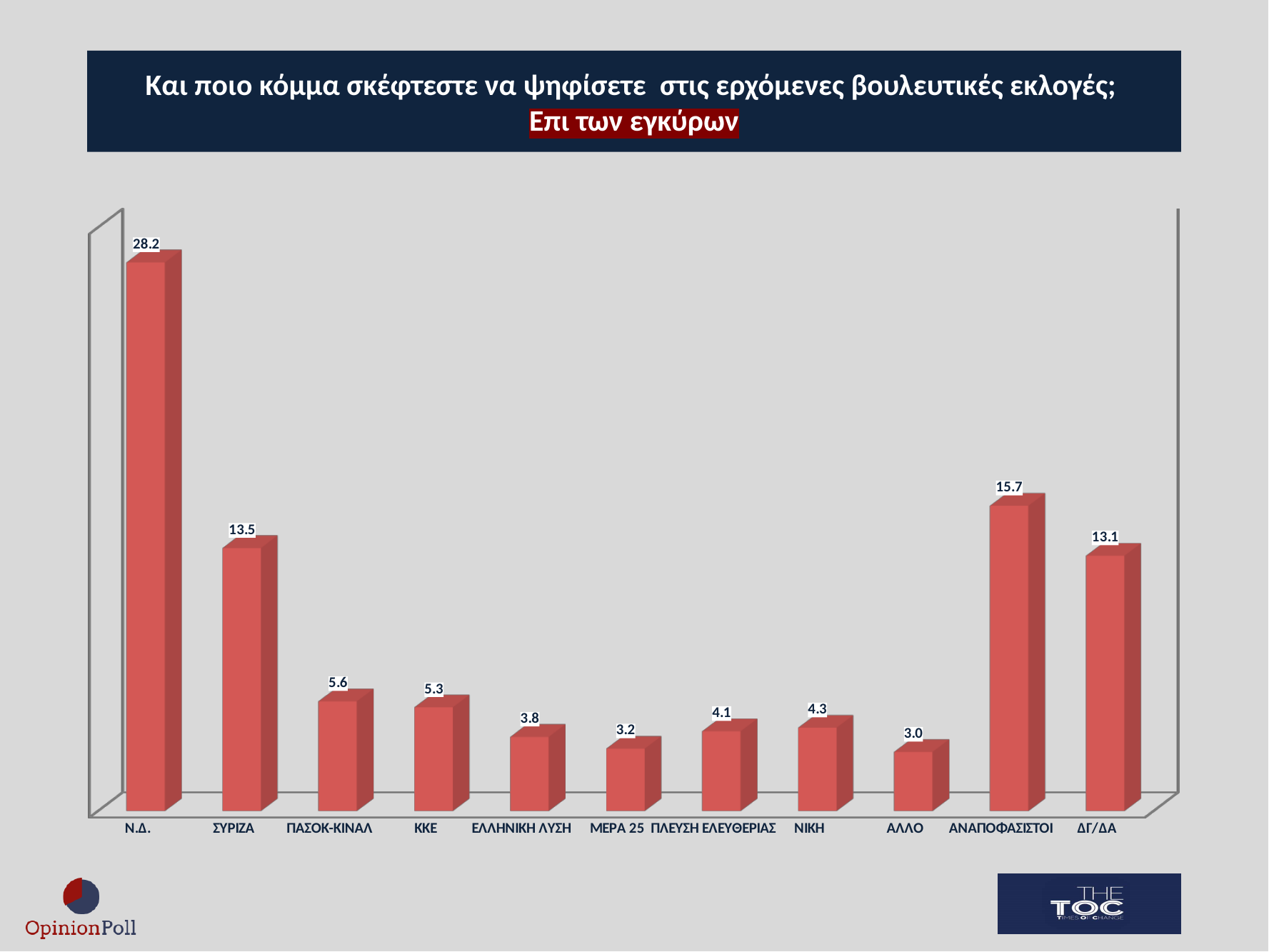
What is the value for ΠΛΕΥΣΗ ΕΛΕΥΘΕΡΙΑΣ? 4.1 What is the difference between the values for Ν.Δ. and ΣΥΡΙΖΑ? 14.7 What colour are the bars in the chart? red How many categories are shown on the x axis? 11 What is the value for ΑΝΑΠΟΦΑΣΙΣΤΟΙ? 15.7 Which is larger, the value for ΠΑΣΟΚ-ΚΙΝΑΛ or the value for ΚΚΕ? ΠΑΣΟΚ-ΚΙΝΑΛ What is the difference between the values for ΑΝΑΠΟΦΑΣΙΣΤΟΙ and ΔΓ/ΔΑ? 2.6 Which category has the highest value? Ν.Δ. What is the value for Ν.Δ.? 28.2 What kind of chart is shown on the slide? bar chart Which category has the lowest value? ΑΛΛΟ What is the value for ΣΥΡΙΖΑ? 13.5